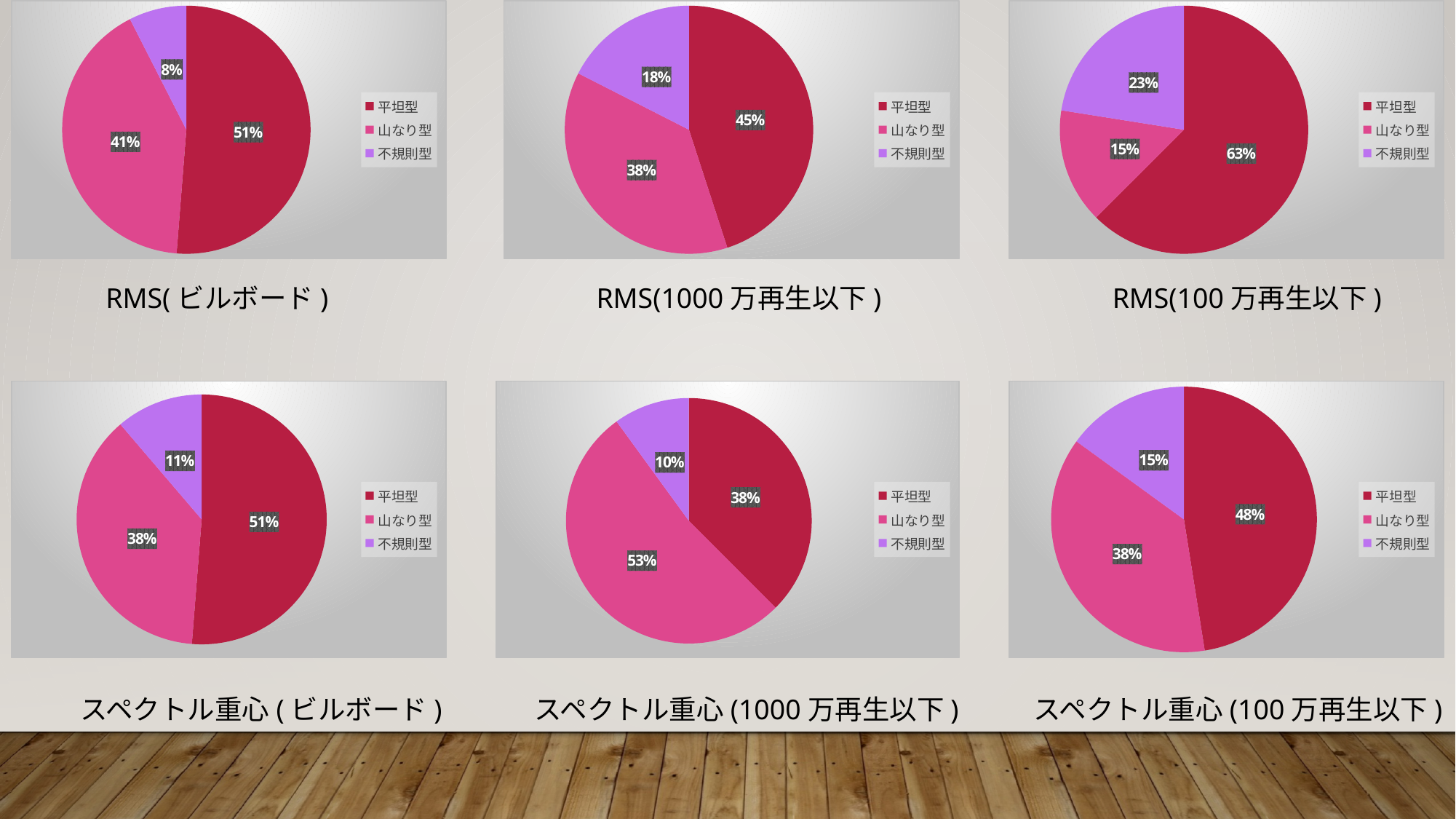
In the スペクトル重心(100万再生以下) pie chart, what is the value for 平坦型? 48% In the RMS(100万再生以下) pie chart, which category has the largest share? 平坦型 In the RMS(1000万再生以下) pie chart, what is the value for 山なり型? 38% How many categories does the legend of the スペクトル重心(100万再生以下) chart list? 3 What kind of chart is the RMS(1000万再生以下) chart? Pie chart In the RMS(100万再生以下) pie chart, what is the difference between the 平坦型 and 不規則型 shares? 40% In the RMS(ビルボード) pie chart, what is the value for 不規則型? 8% In the RMS(ビルボード) pie chart, what share does 平坦型 have? 51% In the スペクトル重心(1000万再生以下) pie chart, which category has the largest share? 山なり型 In the スペクトル重心(ビルボード) pie chart, what is the value for 不規則型? 11% In the スペクトル重心(1000万再生以下) pie chart, which is larger, 平坦型 or 不規則型? 平坦型 In the RMS(100万再生以下) pie chart, which category has the smallest share? 山なり型